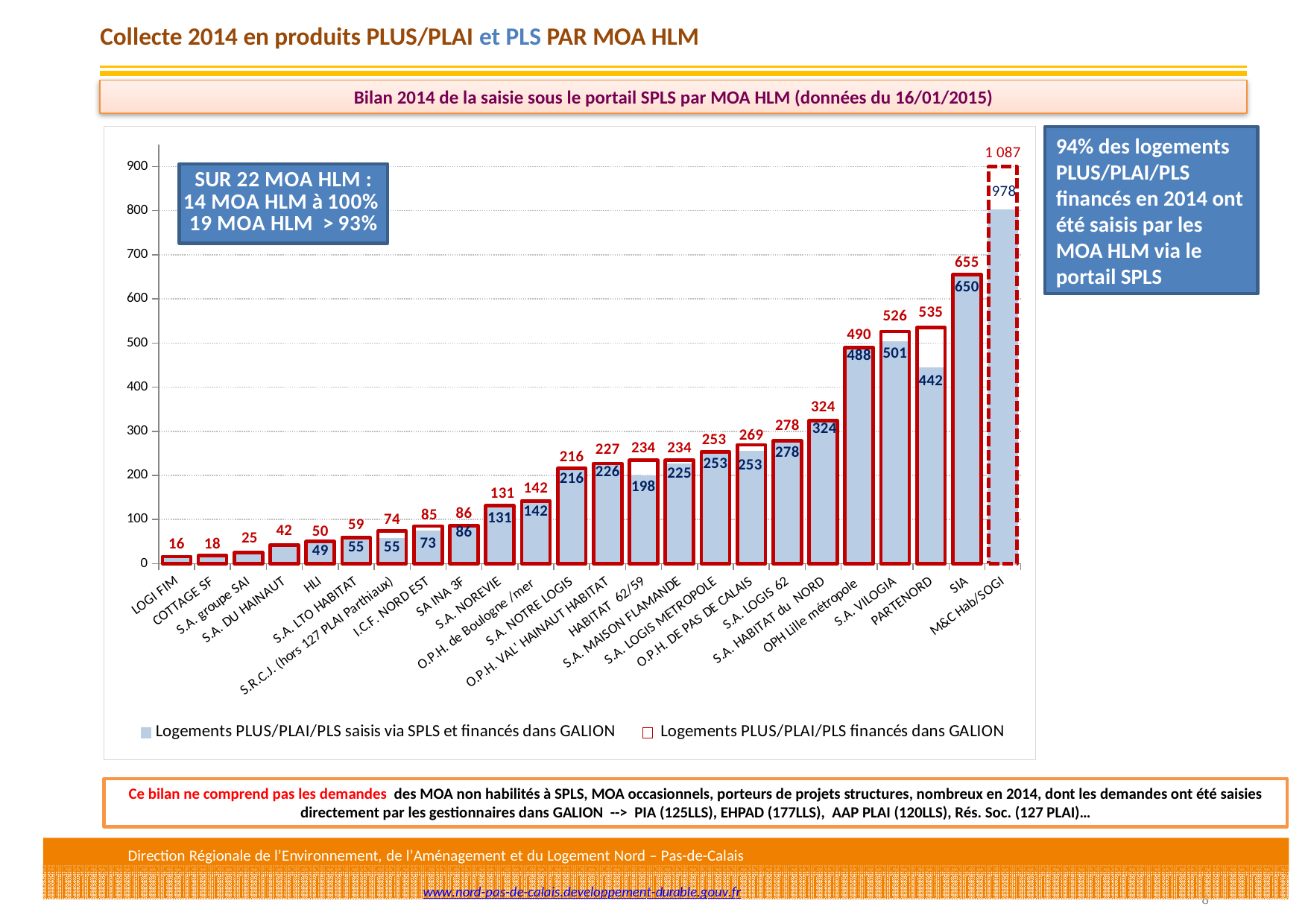
Which has a larger value of Logements PLUS/PLAI/PLS financés dans GALION, S.A. VILOGIA or OPH Lille métropole? S.A. VILOGIA How many series does the legend list? 2 What is the difference between Logements PLUS/PLAI/PLS financés dans GALION and Logements PLUS/PLAI/PLS saisis via SPLS et financés dans GALION for PARTENORD? 93 Do the values of Logements PLUS/PLAI/PLS financés dans GALION rise or fall from left to right along the x axis? rise What is the difference between Logements PLUS/PLAI/PLS financés dans GALION for M&C Hab/SOGI and for SIA? 432 Which MOA HLM has the highest value of Logements PLUS/PLAI/PLS financés dans GALION? M&C Hab/SOGI What is the value of Logements PLUS/PLAI/PLS financés dans GALION for SIA? 655 What kind of chart is shown on the slide? bar chart What is the value of Logements PLUS/PLAI/PLS saisis via SPLS et financés dans GALION for PARTENORD? 442 Which MOA HLM has the lowest value of Logements PLUS/PLAI/PLS financés dans GALION? LOGI FIM What is the value of Logements PLUS/PLAI/PLS financés dans GALION for HABITAT 62/59? 234